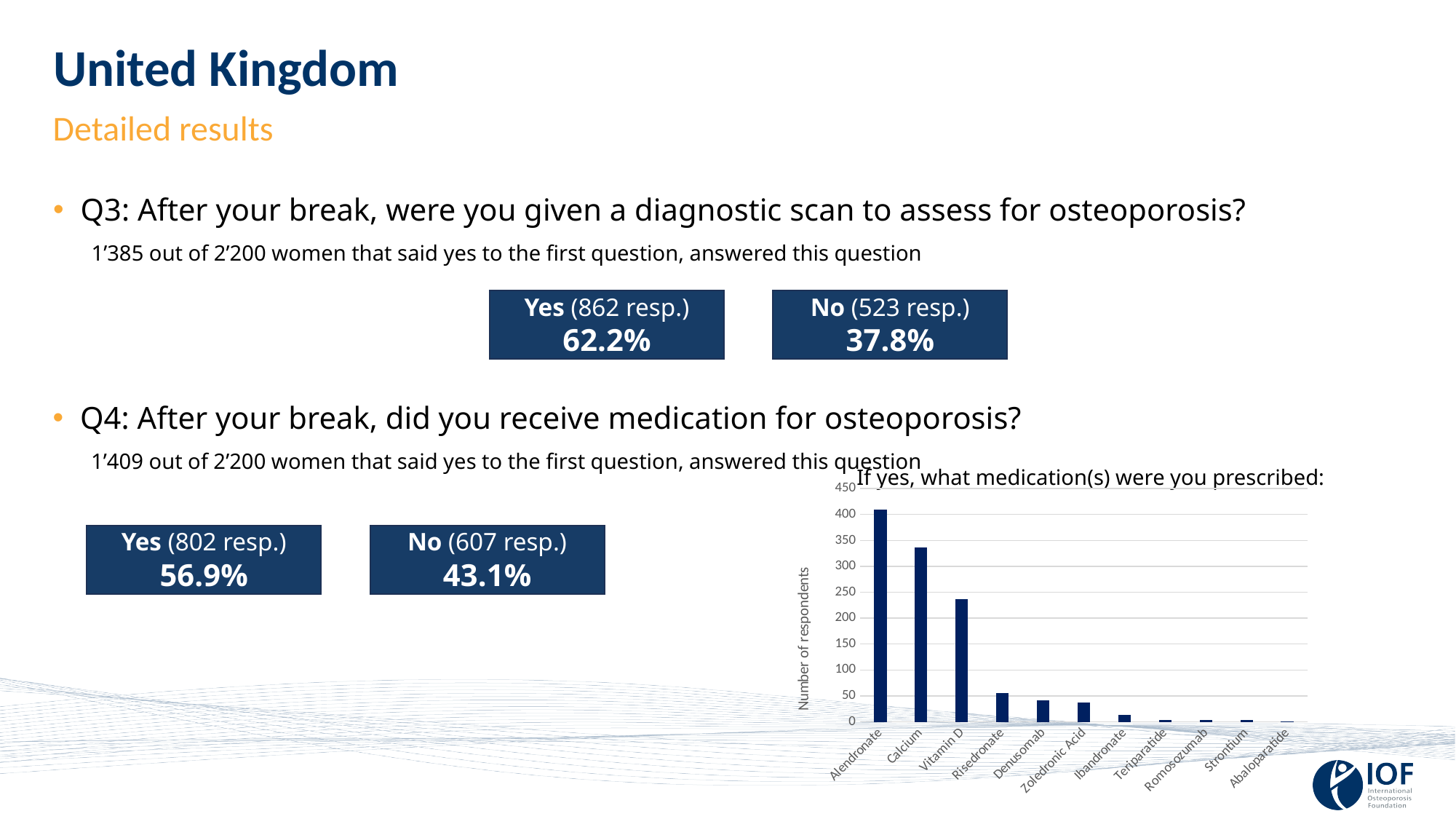
Is the value for Vitamin D greater or less than 300? less What is the label of the vertical axis of the chart? Number of respondents Is the value for Risedronate greater or less than 100? less What is the title of the chart? If yes, what medication(s) were you prescribed: What kind of chart is shown on the slide? bar chart Which has more respondents in the chart, Risedronate or Vitamin D? Vitamin D Is the value for Calcium greater or less than 300? greater Do the values in the chart generally rise or fall from left to right along the x axis? fall Which has more respondents in the chart, Calcium or Vitamin D? Calcium How many medication categories are shown on the x axis of the chart? 11 Which medication has the highest number of respondents in the chart? Alendronate